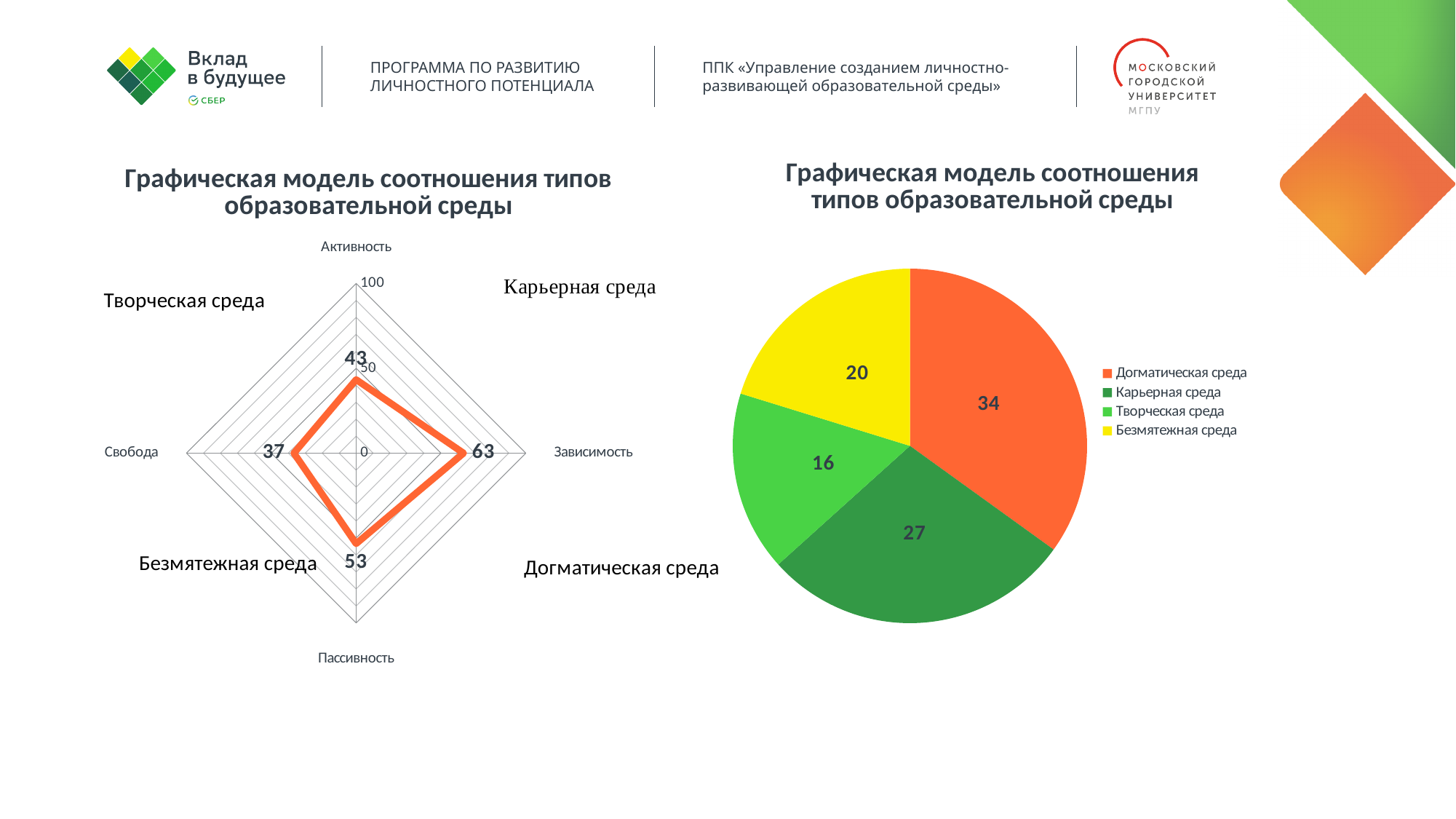
On the right pie chart, what is the value for Карьерная среда? 27 On the right pie chart, which category has the smallest slice? Творческая среда On the left radar chart, which axis has the highest value? Зависимость On the right pie chart, which category has the largest slice? Догматическая среда On the left radar chart, which axis has the lowest value? Свобода On the right pie chart, which colour represents Безмятежная среда? Yellow On the left radar chart, what is the difference between the values for Пассивность and Активность? 10 On the left radar chart, what is the value for Зависимость? 63 On the right pie chart, what is the difference between the values for Догматическая среда and Безмятежная среда? 14 On the left radar chart, how many axes (categories) are plotted? 4 What type of chart is shown on the left side of the slide? Radar chart On the left radar chart, what is the value for Свобода? 37